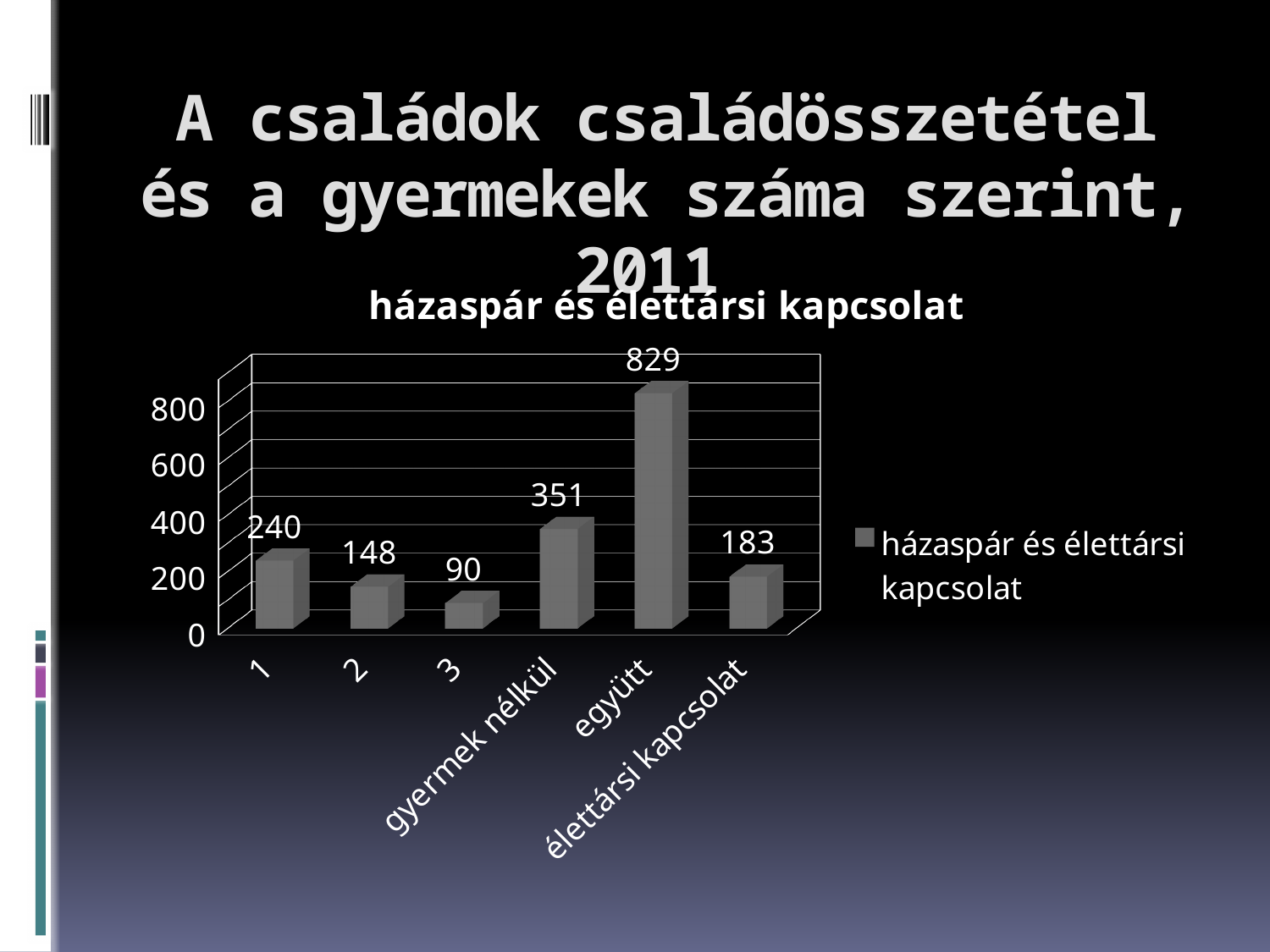
How many categories are shown on the x axis? 6 What kind of chart is shown? bar chart What is the value for the category "1"? 240 What is the title of the chart? házaspár és élettársi kapcsolat What is the value for "élettársi kapcsolat"? 183 What is the difference between the values for "együtt" and "gyermek nélkül"? 478 Which category has the lowest value? 3 What is the value for "gyermek nélkül"? 351 Which is larger, the value for "2" or the value for "élettársi kapcsolat"? élettársi kapcsolat Which category has the highest value? együtt How many series does the legend list? 1 Is the value for "gyermek nélkül" greater or less than 400? less